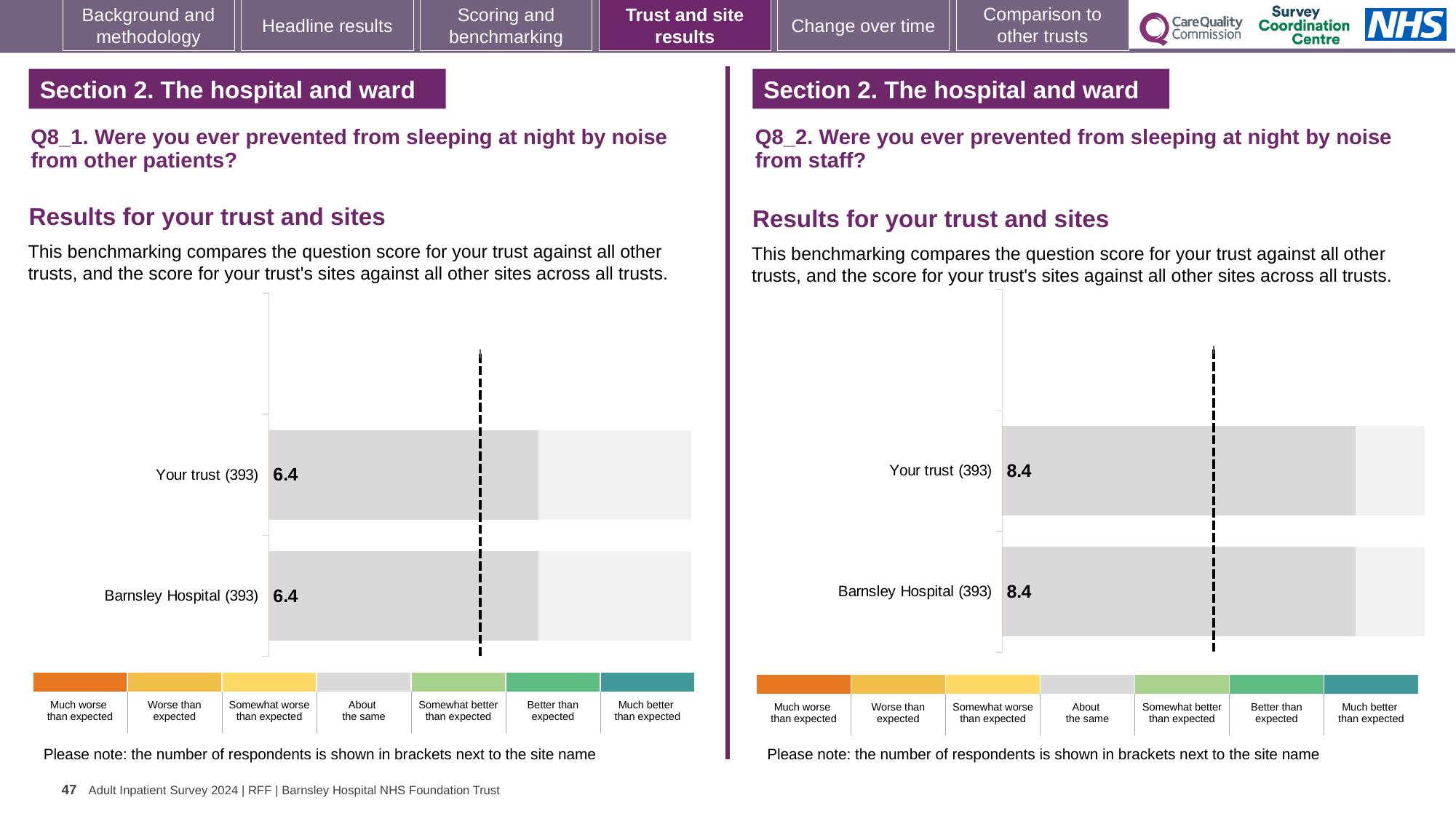
In the Q8_2 chart (right), what is the score for Barnsley Hospital (393)? 8.4 In the Q8_1 chart (left), how many respondents are shown in brackets for Barnsley Hospital? 393 How many benchmark categories does the colour key below the Q8_1 chart (left) list? 7 In the Q8_1 chart (left), what is the score for Your trust (393)? 6.4 In the Q8_1 chart (left), what is the score for Barnsley Hospital (393)? 6.4 In the Q8_2 chart (right), what is the difference between the score for Your trust and the score for Barnsley Hospital? 0 In the Q8_1 chart (left), what is the difference between the score for Your trust and the score for Barnsley Hospital? 0 How many bars are plotted in the Q8_1 chart (left)? 2 In the colour key below the Q8_2 chart (right), which category is shown in grey? About the same How many bars are plotted in the Q8_2 chart (right)? 2 What kind of chart is used for the Q8_2 results (right)? Bar chart In the Q8_2 chart (right), what is the score for Your trust (393)? 8.4